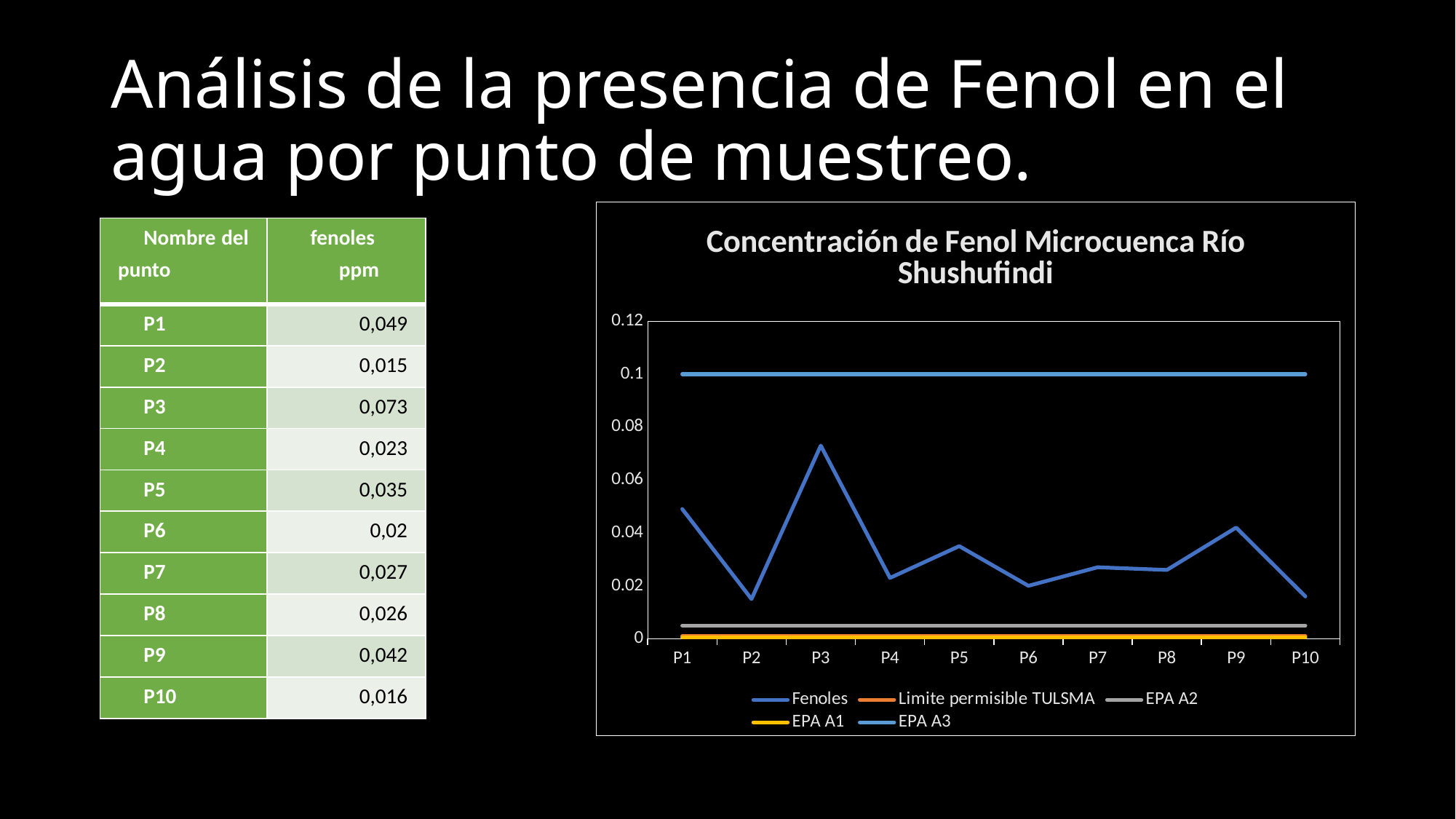
What is the title of the chart? Concentración de Fenol Microcuenca Río Shushufindi Using the table values, what is the difference in fenoles ppm between P3 and P1? 0,024 How many sampling points are plotted along the x axis of the chart? 10 According to the table on the slide, what is the fenoles ppm value for P3? 0,073 At which sampling point is the Fenoles line highest? P3 Which has the larger Fenoles value, P4 or P5? P5 What constant value does the EPA A3 line sit at on the chart? 0.1 Is the Fenoles value at P3 greater or less than 0.06? greater What kind of chart is shown on the slide? line chart Is the Fenoles value at P2 greater or less than 0.02? less How many series does the chart legend list? 5 Does the Fenoles line rise or fall from P9 to P10? fall